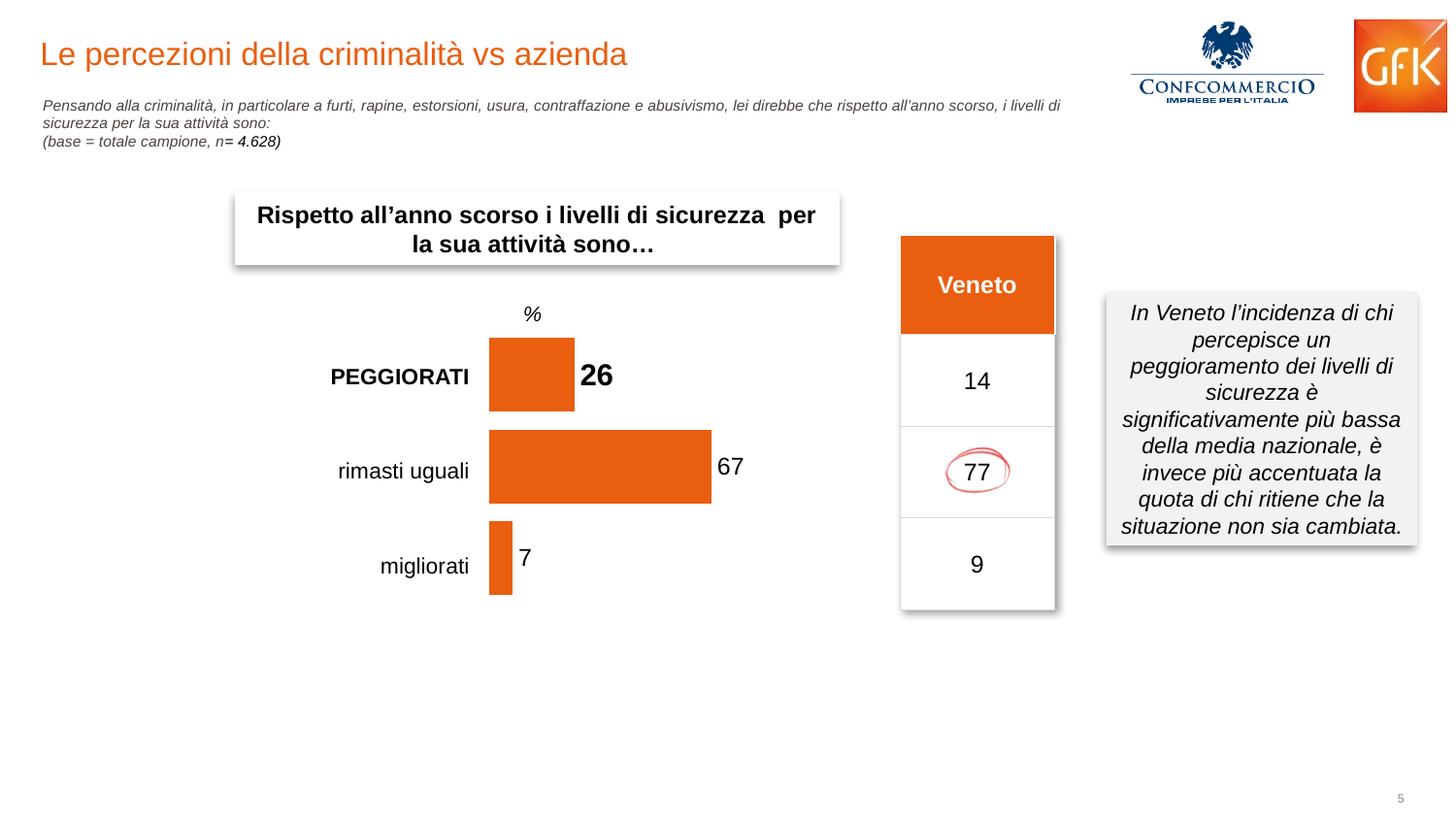
What is the difference between the values for rimasti uguali and PEGGIORATI in the bar chart? 41 Which category has the lowest value in the bar chart? migliorati Which category has the highest value in the bar chart? rimasti uguali What is the value for PEGGIORATI in the bar chart? 26 How many categories does the bar chart show? 3 What is the difference between the values for PEGGIORATI and migliorati in the bar chart? 19 What kind of chart is shown on the slide? bar chart What is the value for migliorati in the bar chart? 7 Which is larger in the bar chart, PEGGIORATI or migliorati? PEGGIORATI What is the title shown above the bar chart? Rispetto all'anno scorso i livelli di sicurezza per la sua attività sono… What unit is indicated above the bars in the bar chart? % What is the value for rimasti uguali in the bar chart? 67